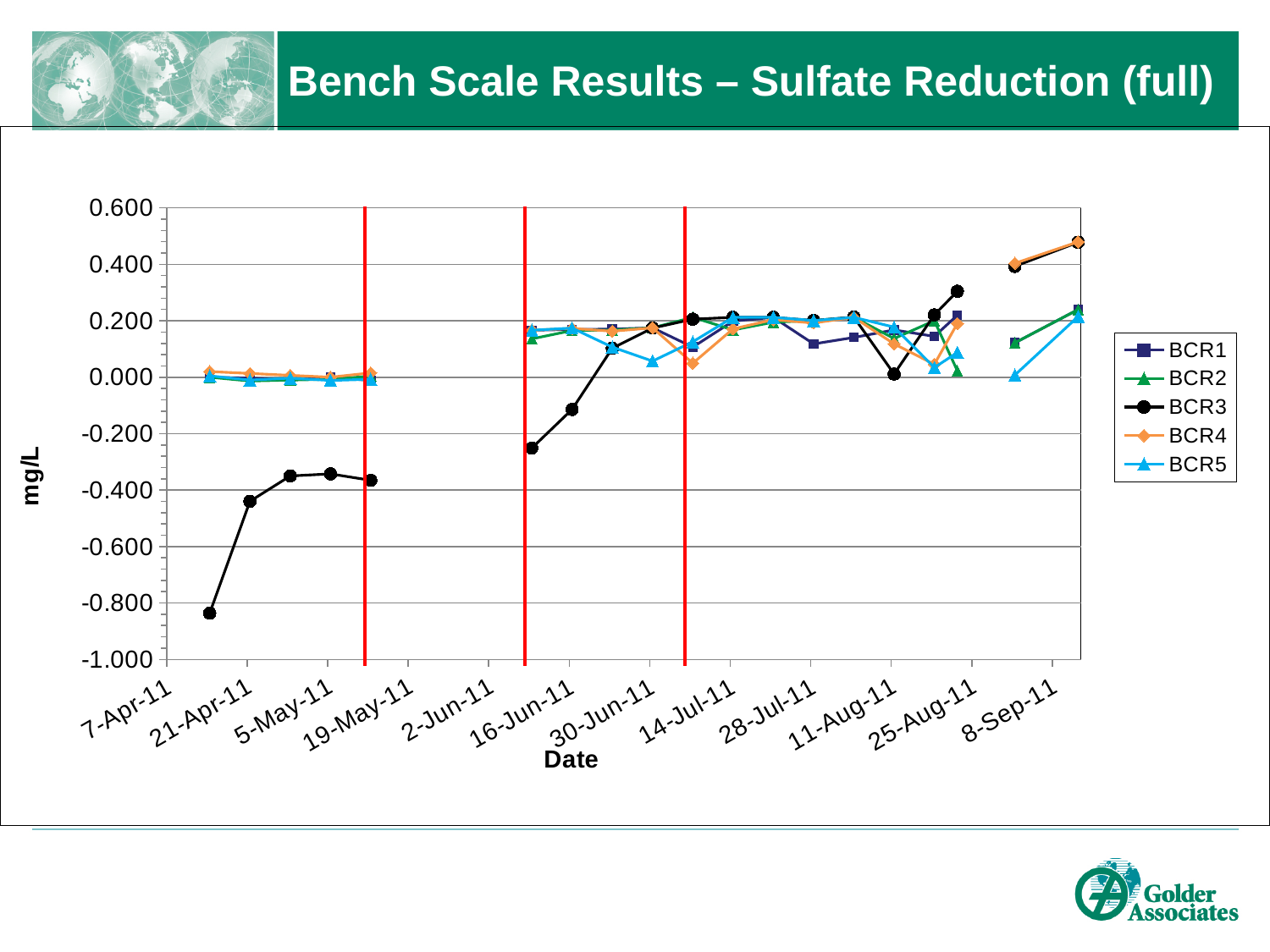
How many series does the legend list? 5 Is the last plotted value for BCR4 (after 8-Sep-11) greater or less than 0.400? greater Is the value for BCR3 near 25-Aug-11 greater or less than 0.200? greater Near 16-Jun-11, is the value for BCR2 larger or smaller than the value for BCR3? larger What is the label on the vertical axis? mg/L Is the value for BCR3 near 16-Jun-11 greater or less than 0.000? less Does the BCR3 series rise or fall between 7-Apr-11 and 19-May-11? rise What are the series names listed in the legend? BCR1, BCR2, BCR3, BCR4, BCR5 Which series has the lowest value plotted on the chart? BCR3 What kind of chart is shown on the slide? line chart